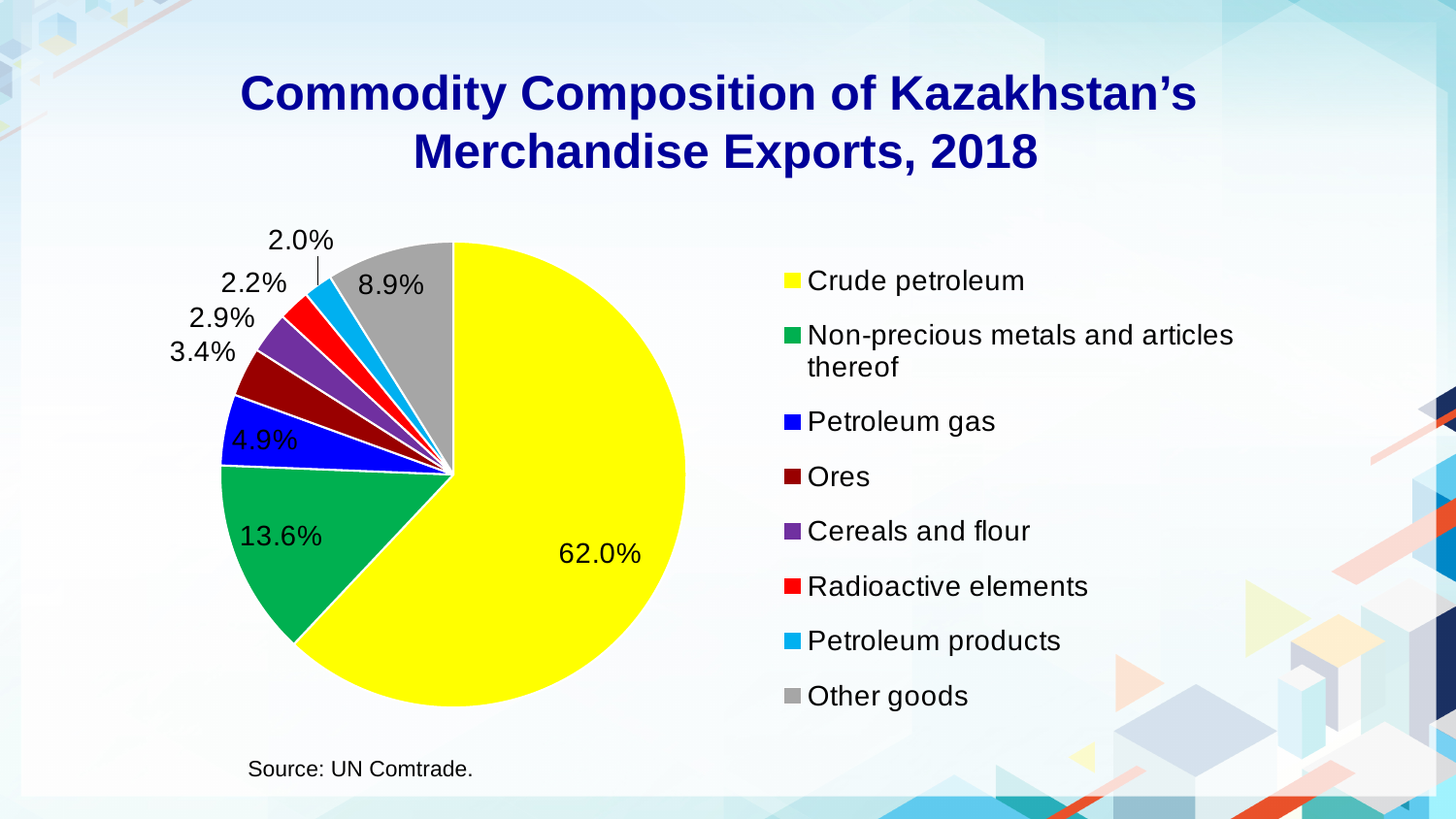
How many commodity categories are shown in the pie chart? 8 What colour represents Cereals and flour in the pie chart? Purple What kind of chart is shown on the slide? Pie chart What share of exports is Ores? 3.4% What share of exports is Non-precious metals and articles thereof? 13.6% Which commodity category has the largest share of exports? Crude petroleum What share of Kazakhstan's merchandise exports in 2018 is Crude petroleum? 62.0% What share of exports is Other goods? 8.9% What share of exports is Petroleum gas? 4.9% Which commodity category has the smallest share of exports? Petroleum products What is the difference in share between Crude petroleum and Non-precious metals and articles thereof? 48.4 percentage points Which has a larger share of exports, Other goods or Petroleum gas? Other goods